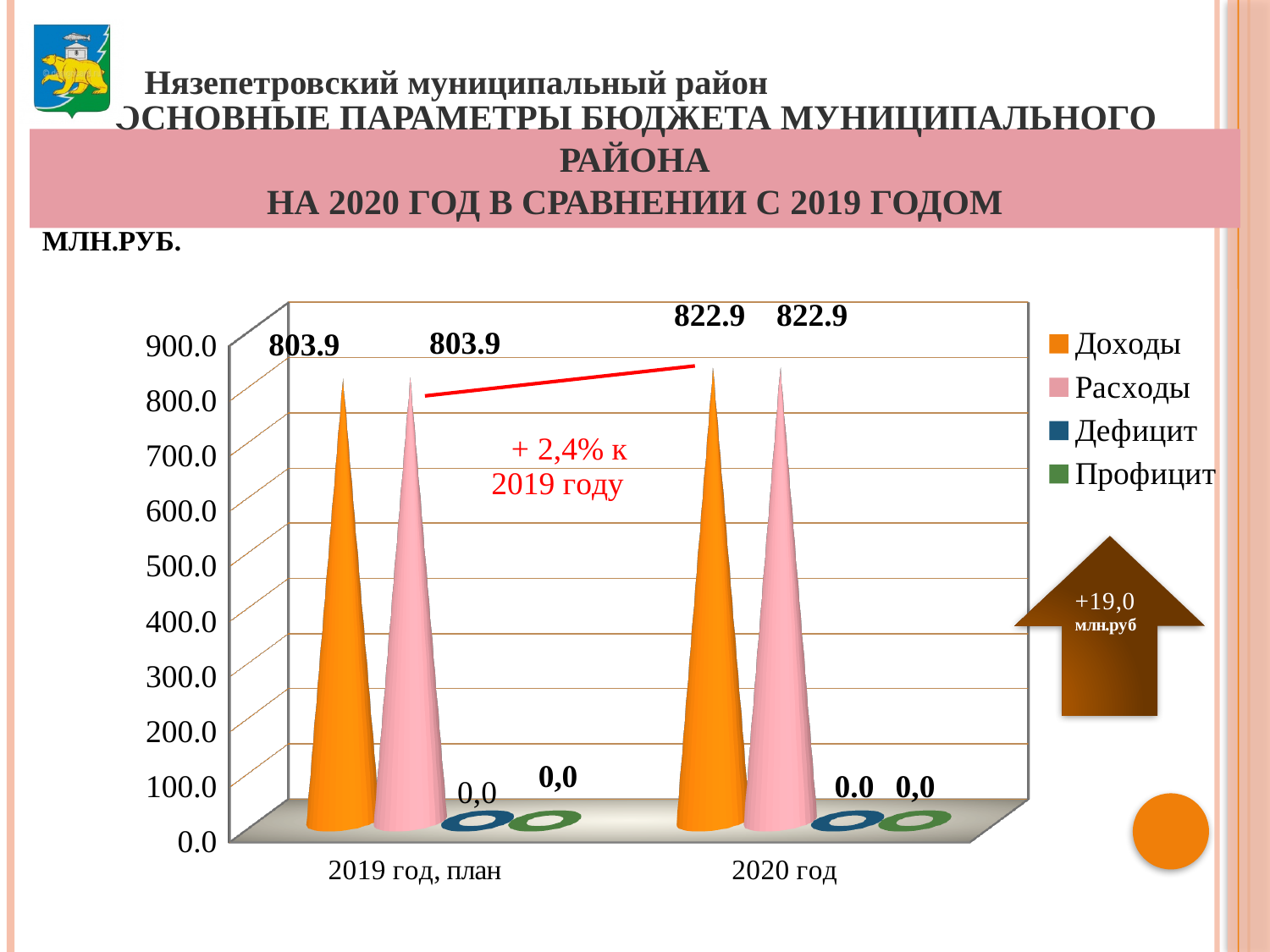
How many series does the legend list? 4 What is the value of Расходы for 2019 год, план? 803.9 By how much do Доходы in 2020 год exceed Доходы in 2019 год, план? 19.0 Is the value of Доходы for 2020 год greater or less than 800.0? greater Which legend entry is shown in orange? Доходы What kind of chart is shown on the slide? bar chart How many categories are shown on the x axis? 2 What is the value of Дефицит for 2020 год? 0.0 What is the value of Доходы for 2019 год, план? 803.9 Do the Доходы values rise or fall from 2019 год, план to 2020 год? rise What is the value of Доходы for 2020 год? 822.9 Which year has the higher value for Расходы, 2019 год, план or 2020 год? 2020 год